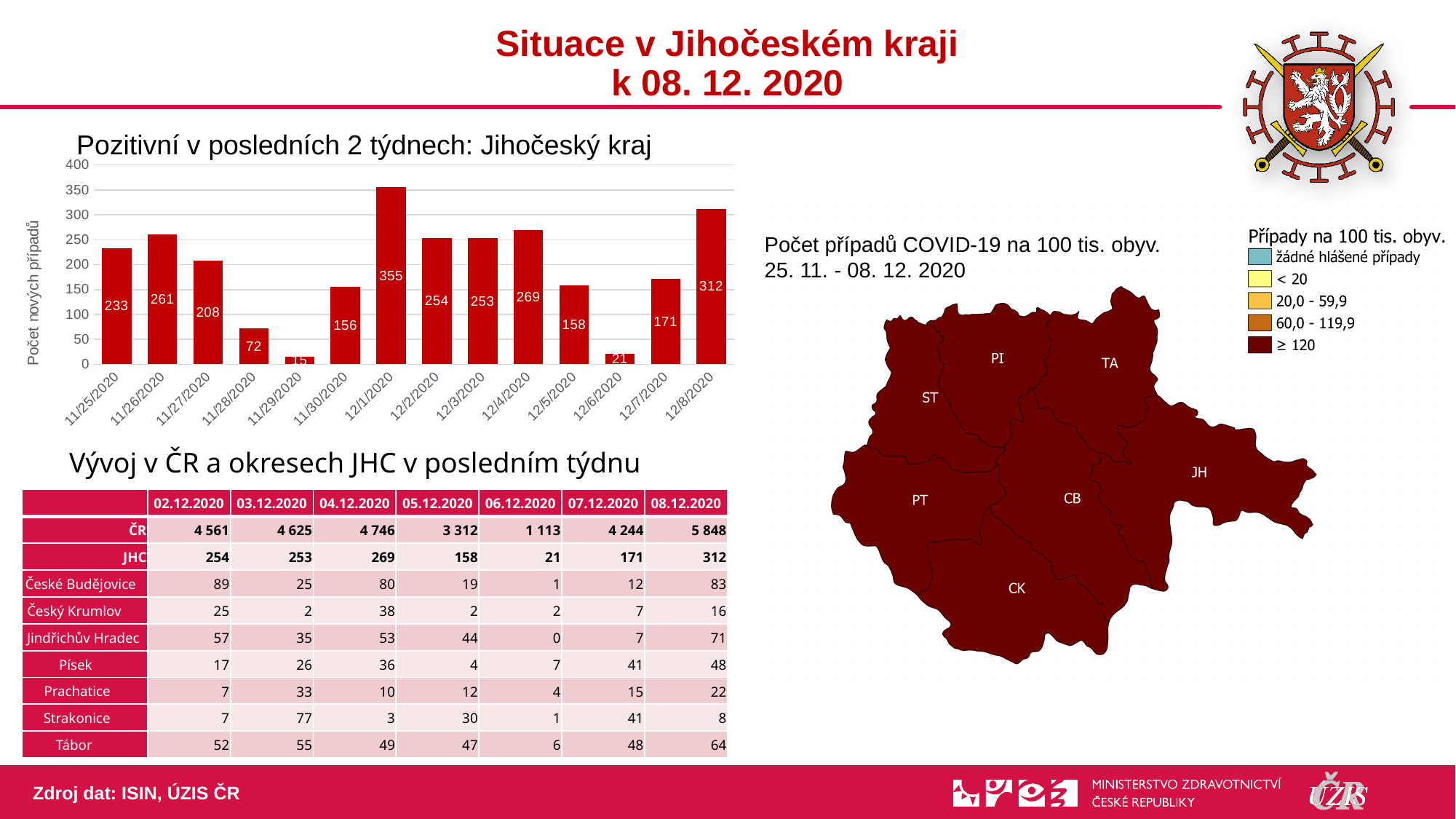
Which has the larger value in the bar chart, 11/26/2020 or 11/27/2020? 11/26/2020 Is the value for 11/30/2020 in the bar chart greater or less than 200? less What is the difference between the values for 12/8/2020 and 12/7/2020 in the bar chart? 141 What kind of chart is 'Pozitivní v posledních 2 týdnech: Jihočeský kraj'? bar chart Does the value rise or fall from 12/5/2020 to 12/6/2020 in the bar chart? fall What is the value for 11/25/2020 in the bar chart? 233 How many dates are shown on the x axis of the bar chart? 14 What is the value for 12/1/2020 in the chart 'Pozitivní v posledních 2 týdnech: Jihočeský kraj'? 355 Which date has the lowest value in the bar chart? 11/29/2020 Which date has the highest value in the bar chart? 12/1/2020 What is the y-axis title of the bar chart? Počet nových případů What is the value for 12/4/2020 in the bar chart? 269